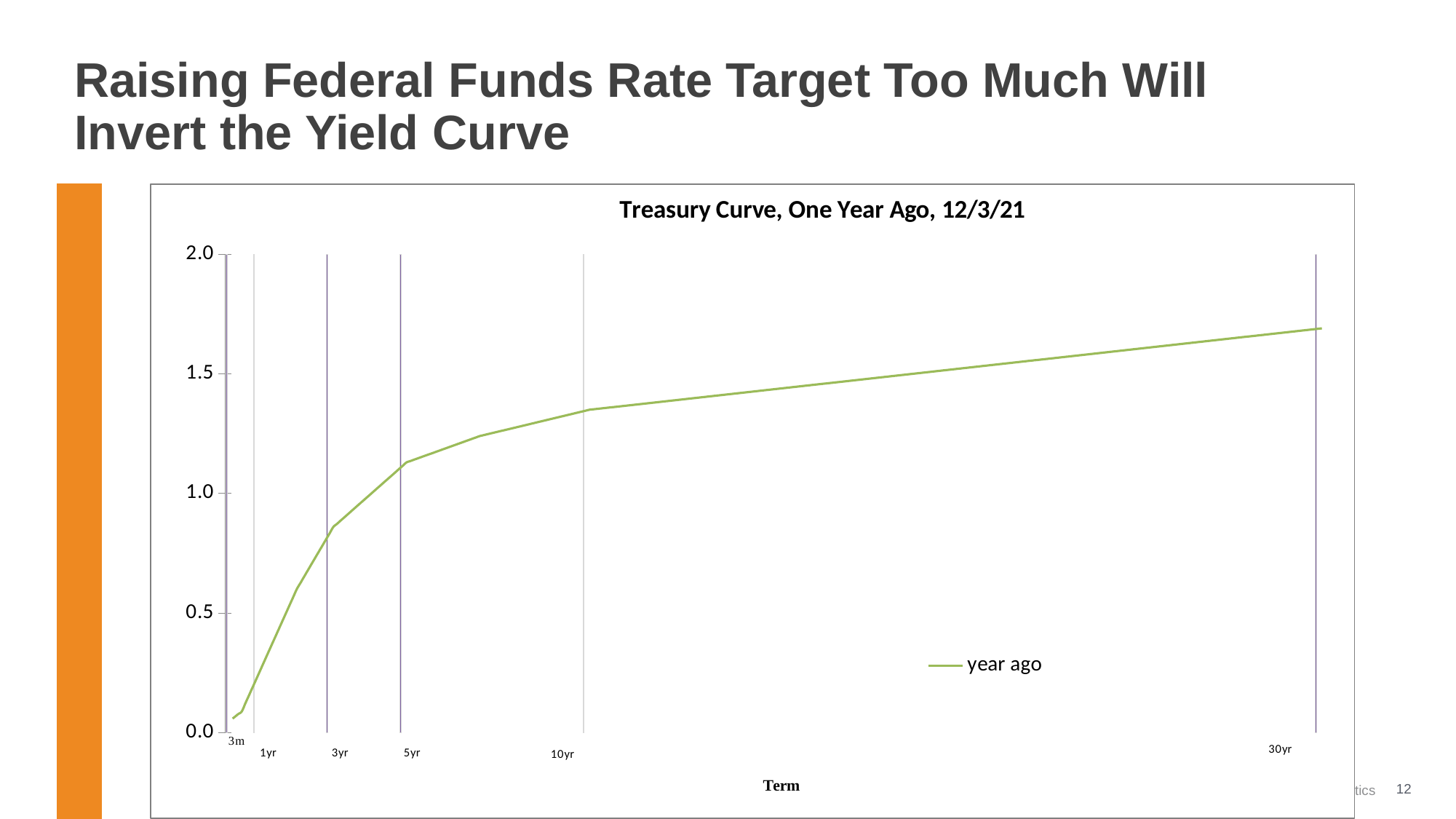
Which term has the highest yield on the curve? 30yr What is the title of the chart? Treasury Curve, One Year Ago, 12/3/21 Which term has the lowest yield on the curve? 3m Is the value for 3yr greater or less than 1.0? less How many series does the legend list? 1 Do the yields rise or fall as the term increases along the x axis? rise Which has the larger yield, 10yr or 3yr? 10yr What kind of chart is shown on the slide? line chart What is the name of the series shown in the legend? year ago Is the value for 30yr greater or less than 1.5? greater How many term categories are labeled on the x axis? 6 Is the value for 1yr greater or less than 0.5? less